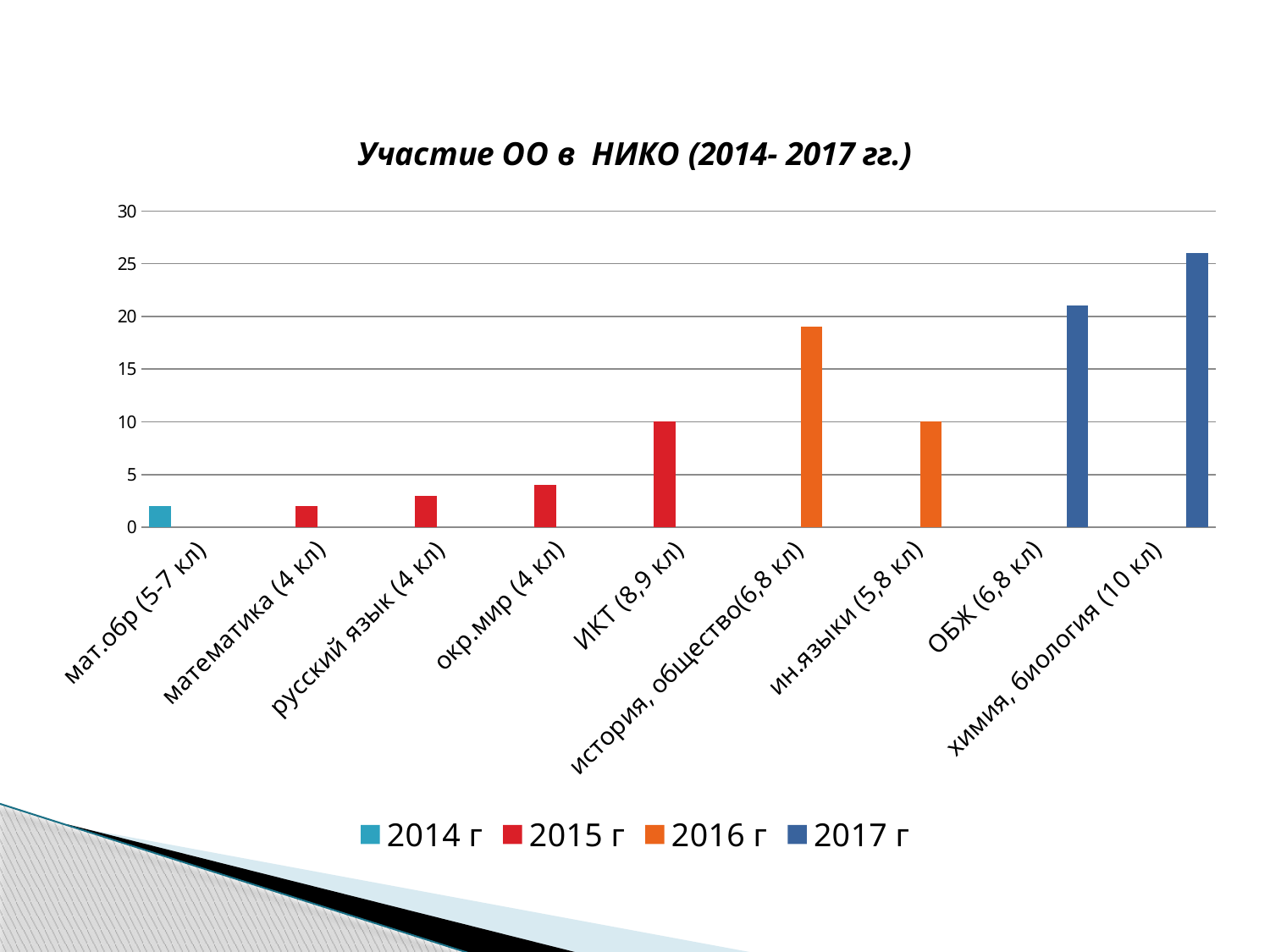
What is the value for ин.языки (5,8 кл)? 10 Is the value for ОБЖ (6,8 кл) greater or less than 20? greater Which category has the highest value? химия, биология (10 кл) What is the title of the chart? Участие ОО в НИКО (2014- 2017 гг.) Which is larger, the value for история, общество(6,8 кл) or the value for ИКТ (8,9 кл)? история, общество(6,8 кл) Is the value for история, общество(6,8 кл) greater or less than 15? greater Which legend entry is shown in orange? 2016 г Is the value for окр.мир (4 кл) greater or less than 5? less How many series does the legend list? 4 What is the value for ИКТ (8,9 кл)? 10 What type of chart is shown on the slide? bar chart How many categories are shown on the x axis? 9